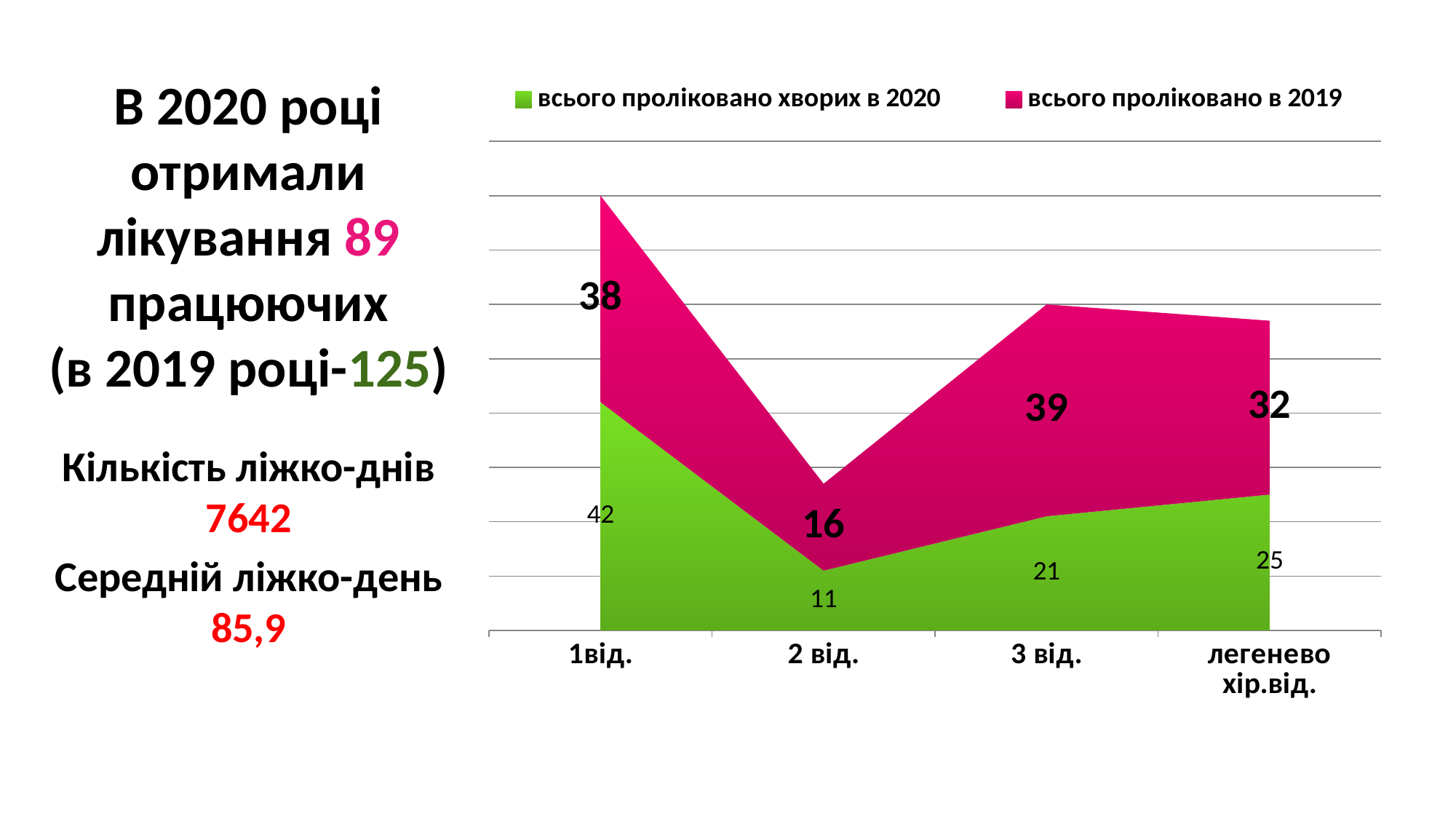
What is the difference between the 2019 and 2020 values for 2 від.? 5 How many categories are shown on the x axis? 4 Which category has the lowest value in the series 'всього проліковано хворих в 2020'? 2 від. Which colour represents the series 'всього проліковано в 2019'? pink (magenta) What is the value for легенево хір.від. in the series 'всього проліковано хворих в 2020'? 25 What is the value for 1від. in the series 'всього проліковано хворих в 2020'? 42 Which category has the highest value in the series 'всього проліковано в 2019'? 3 від. What is the value for 3 від. in the series 'всього проліковано в 2019'? 39 What kind of chart is shown on the slide? stacked area chart Which is larger for 1від.: the 2020 value or the 2019 value? the 2020 value (42) How many series does the legend list? 2 What is the combined total of the 2020 and 2019 values for 3 від.? 60